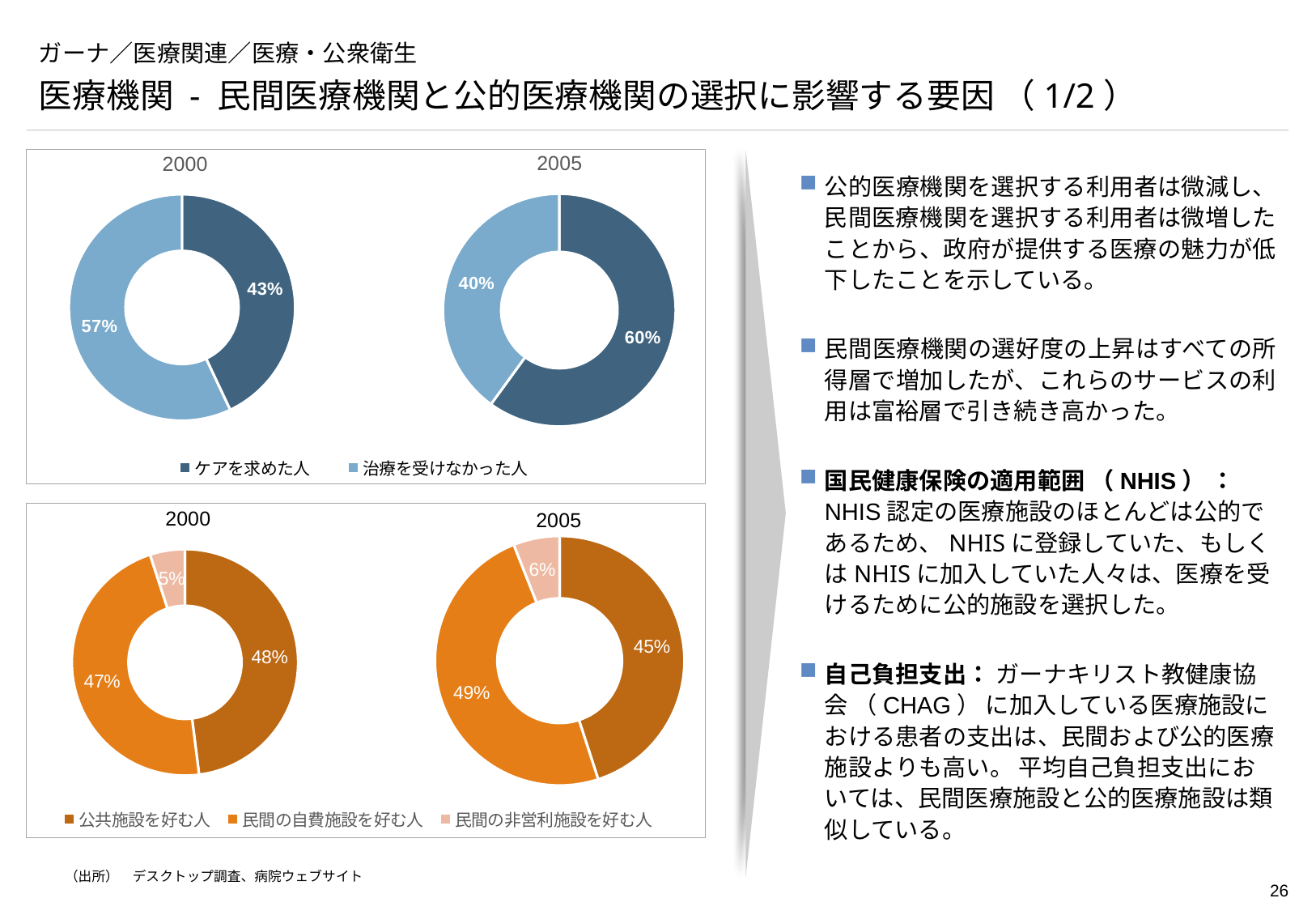
In the top-left donut chart (2000), what percentage is shown for 治療を受けなかった人? 57% What type of chart is used in the top-left chart (2000)? Donut (pie) chart In the top-right donut chart (2005), what percentage is shown for ケアを求めた人? 60% In the bottom-right donut chart (2005), what percentage is shown for 民間の自費施設を好む人? 49% How many series does the legend of the bottom pair of donut charts list? 3 In the bottom-right donut chart (2005), which category has the smallest slice? 民間の非営利施設を好む人 In the bottom-left donut chart (2000), what percentage is shown for 民間の非営利施設を好む人? 5% In the top-right donut chart (2005), what percentage is shown for 治療を受けなかった人? 40% In the bottom-left donut chart (2000), what percentage is shown for 公共施設を好む人? 48% In the top-left donut chart (2000), what percentage is shown for ケアを求めた人? 43% In the bottom-right donut chart (2005), what is the difference between 民間の自費施設を好む人 and 公共施設を好む人? 4% In the top-right donut chart (2005), what is the difference between the two slices? 20%